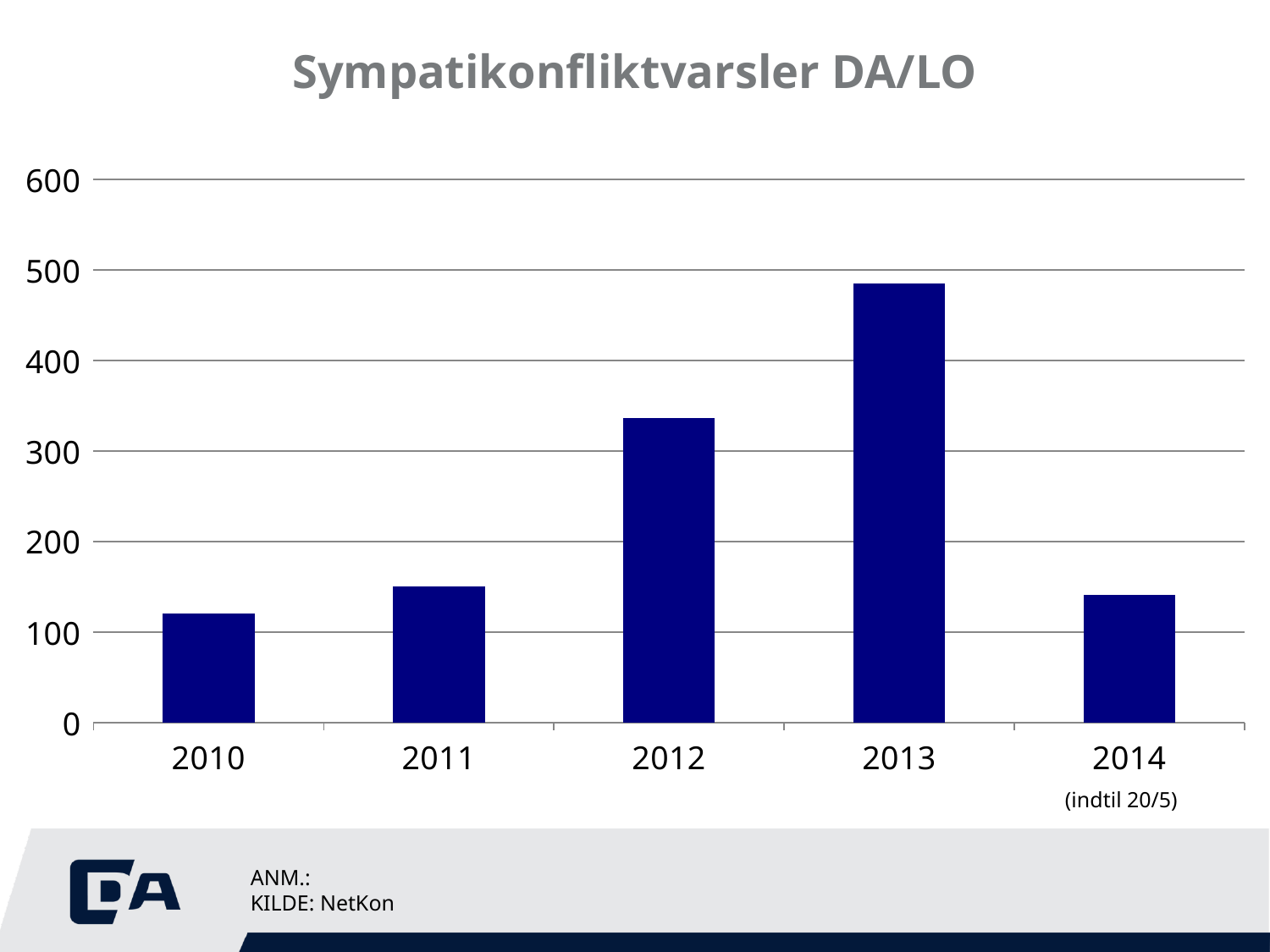
Is the value for 2013 greater or less than 400? greater Is the value for 2010 greater or less than 100? greater What is the title of the chart? Sympatikonfliktvarsler DA/LO Which is larger, the value for 2012 or the value for 2013? 2013 Which year has the highest value in the chart? 2013 Which year has the lowest value in the chart? 2010 Do the values rise or fall from 2010 to 2013? rise How many years are shown on the x axis of the chart? 5 Is the value for 2014 greater or less than 200? less What kind of chart is shown on the slide? bar chart